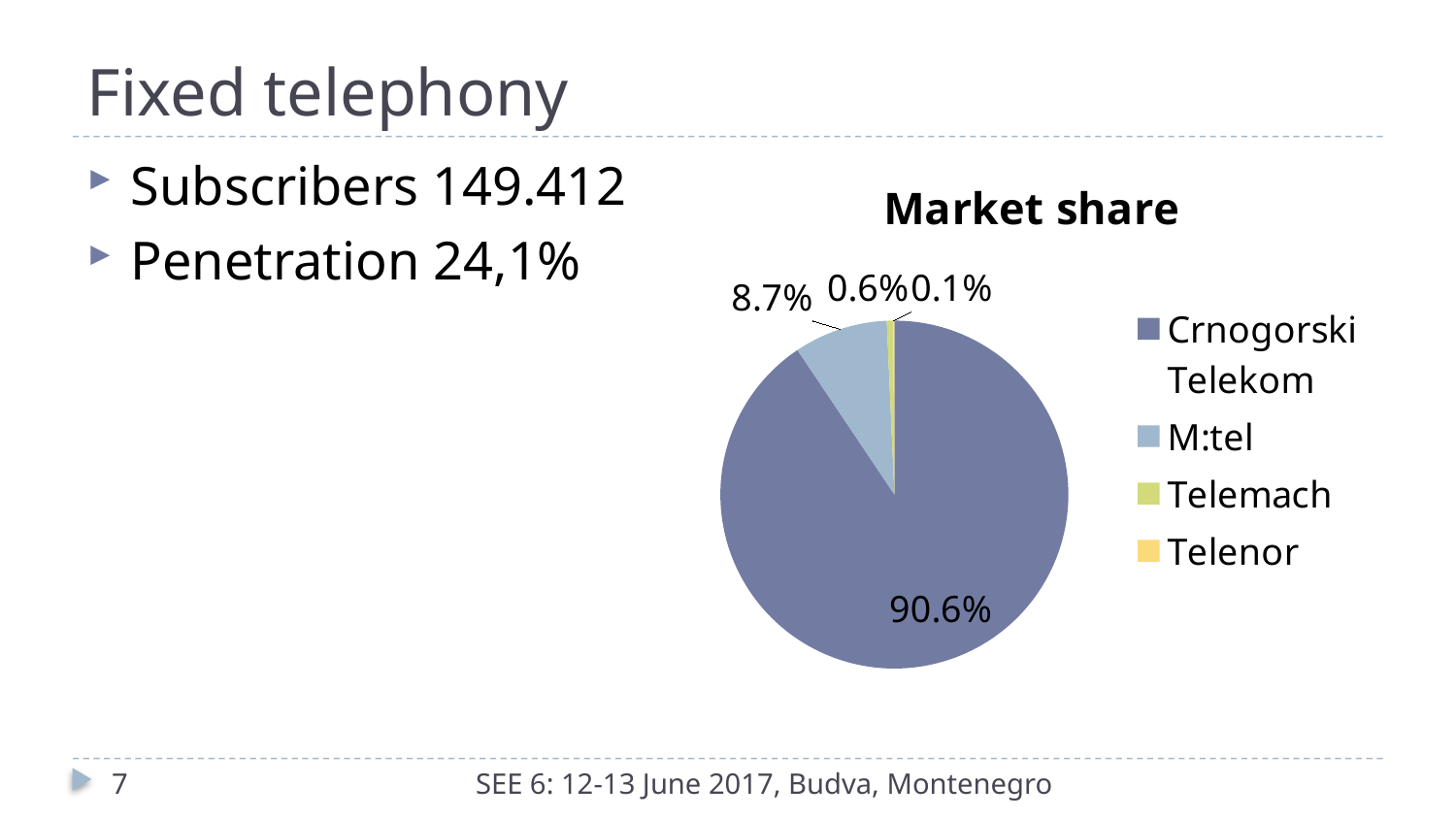
What kind of chart is shown on the slide? pie chart What is the market share of M:tel? 8.7% What is the title of the chart? Market share What is the market share of Telenor? 0.1% How many entries does the legend list? 4 What is the market share of Telemach? 0.6% What is the difference in market share between Crnogorski Telekom and M:tel? 81.9% How many operators are shown in the pie chart? 4 Which operator has the largest market share? Crnogorski Telekom What is the market share of Crnogorski Telekom? 90.6% Which operator has the smallest market share? Telenor Which has a larger market share, M:tel or Telemach? M:tel